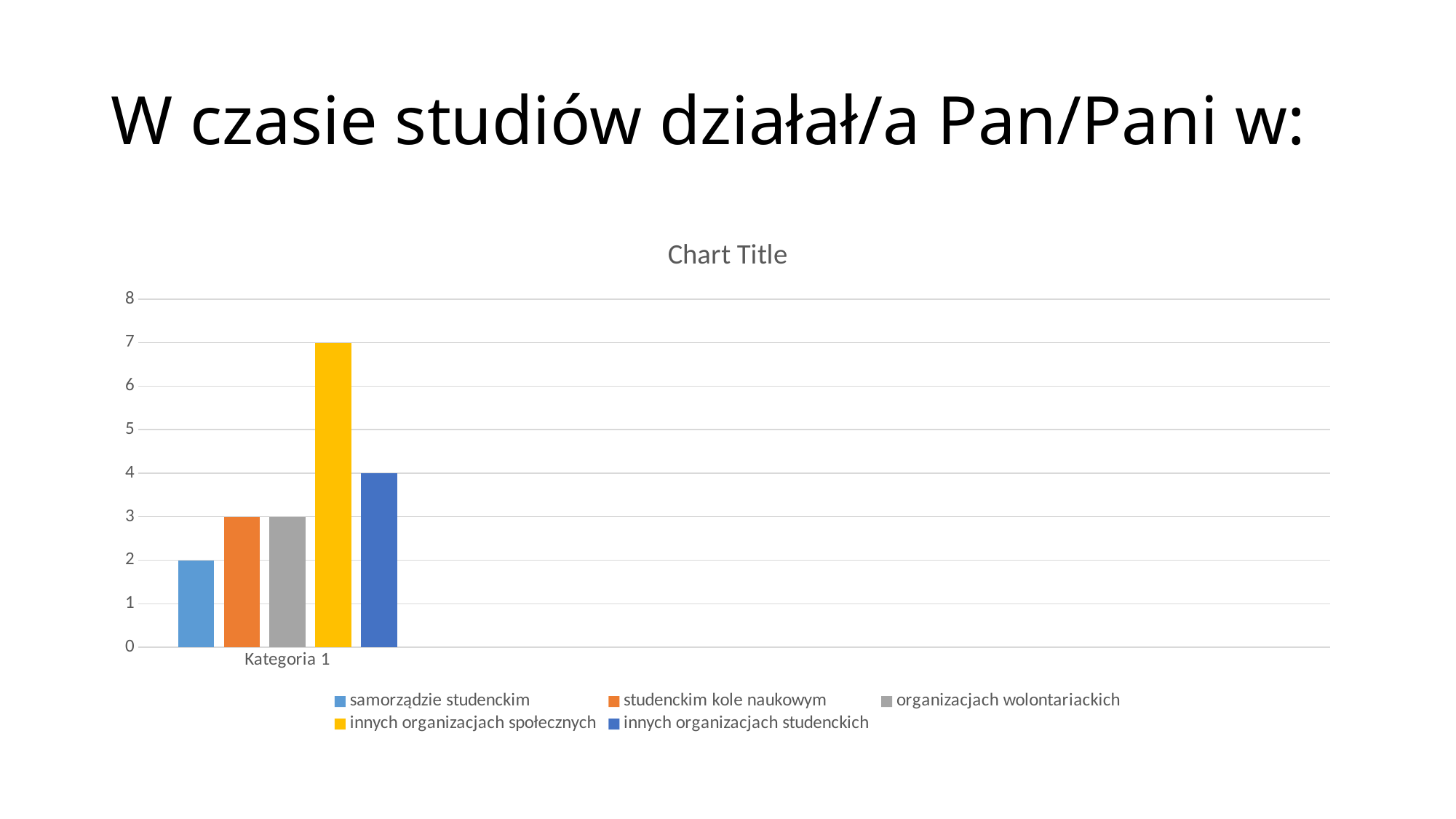
Which series has the highest value? innych organizacjach społecznych What is the value for 'studenckim kole naukowym'? 3 What is the value for 'samorządzie studenckim'? 2 How many categories are shown on the x axis? 1 What is the difference between the values for 'innych organizacjach społecznych' and 'innych organizacjach studenckich'? 3 Which is larger, the value for 'innych organizacjach studenckich' or the value for 'organizacjach wolontariackich'? innych organizacjach studenckich What kind of chart is shown on the slide? bar chart Which series has the lowest value? samorządzie studenckim What is the value for 'innych organizacjach społecznych'? 7 What is the value for 'innych organizacjach studenckich'? 4 How many series does the legend list? 5 What is the title shown above the chart? Chart Title